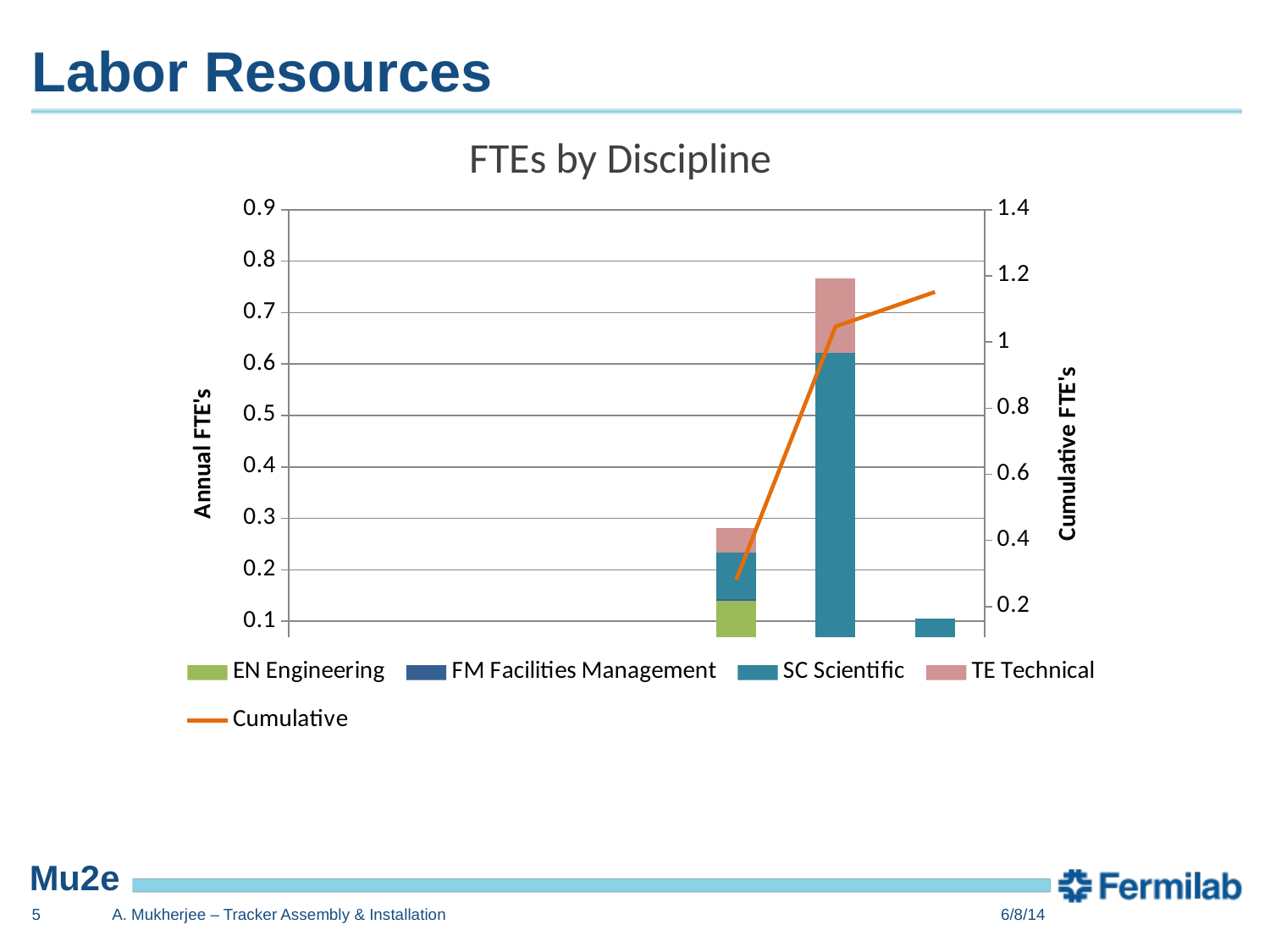
Does the Cumulative line rise or fall from left to right? Rises What is the title of the chart? FTEs by Discipline Which of the visible bars is the tallest: the first, second or third? The second How many stacked bars are visible in the chart? 3 Which legend entry is drawn as a line rather than bars? Cumulative Is the first stacked bar taller or shorter than the third stacked bar? Taller How many series does the chart's legend list? 5 Is the total height of the first stacked bar greater or less than 0.4 on the Annual FTE's axis? less Is the total height of the tallest stacked bar greater or less than 0.7 on the Annual FTE's axis? greater Is the last point of the Cumulative line greater or less than 1 on the Cumulative FTE's axis? greater Which of the visible bars is the shortest: the first, second or third? The third What kind of chart is shown on the slide? Stacked bar chart with a line